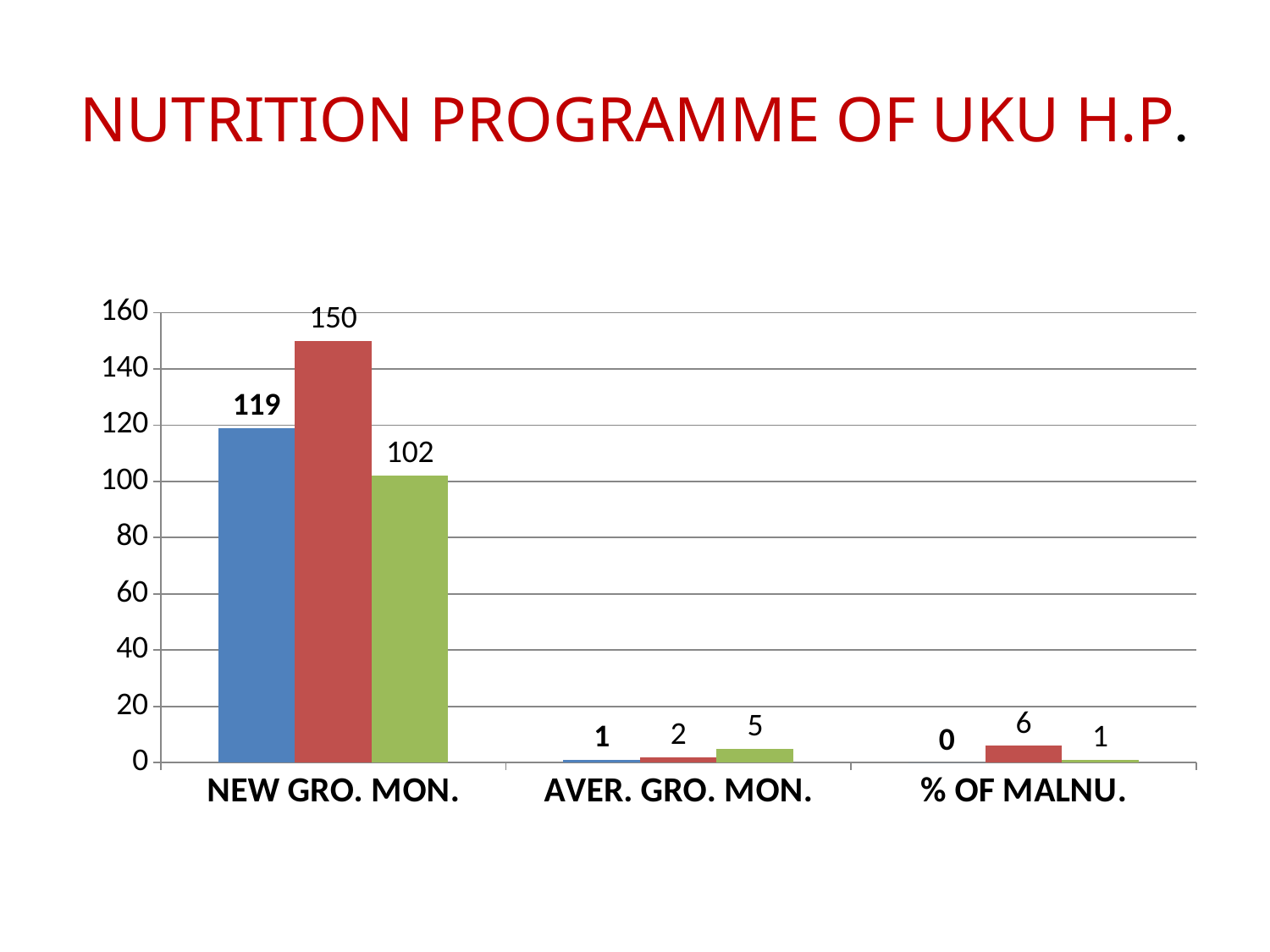
Which bar in the NEW GRO. MON. category has the highest value? the red bar (150) Which bar in the NEW GRO. MON. category has the lowest value? the green bar (102) What is the value of the red bar for % OF MALNU.? 6 What is the value of the green bar for AVER. GRO. MON.? 5 What is the value of the blue bar for % OF MALNU.? 0 What is the value of the blue bar for NEW GRO. MON.? 119 What is the difference between the red bar and the green bar for NEW GRO. MON.? 48 How many categories are shown on the x axis? 3 What type of chart is shown on the slide? bar chart What is the title of the slide? NUTRITION PROGRAMME OF UKU H.P. Which is larger for AVER. GRO. MON., the red bar or the green bar? the green bar What is the value of the red bar for NEW GRO. MON.? 150